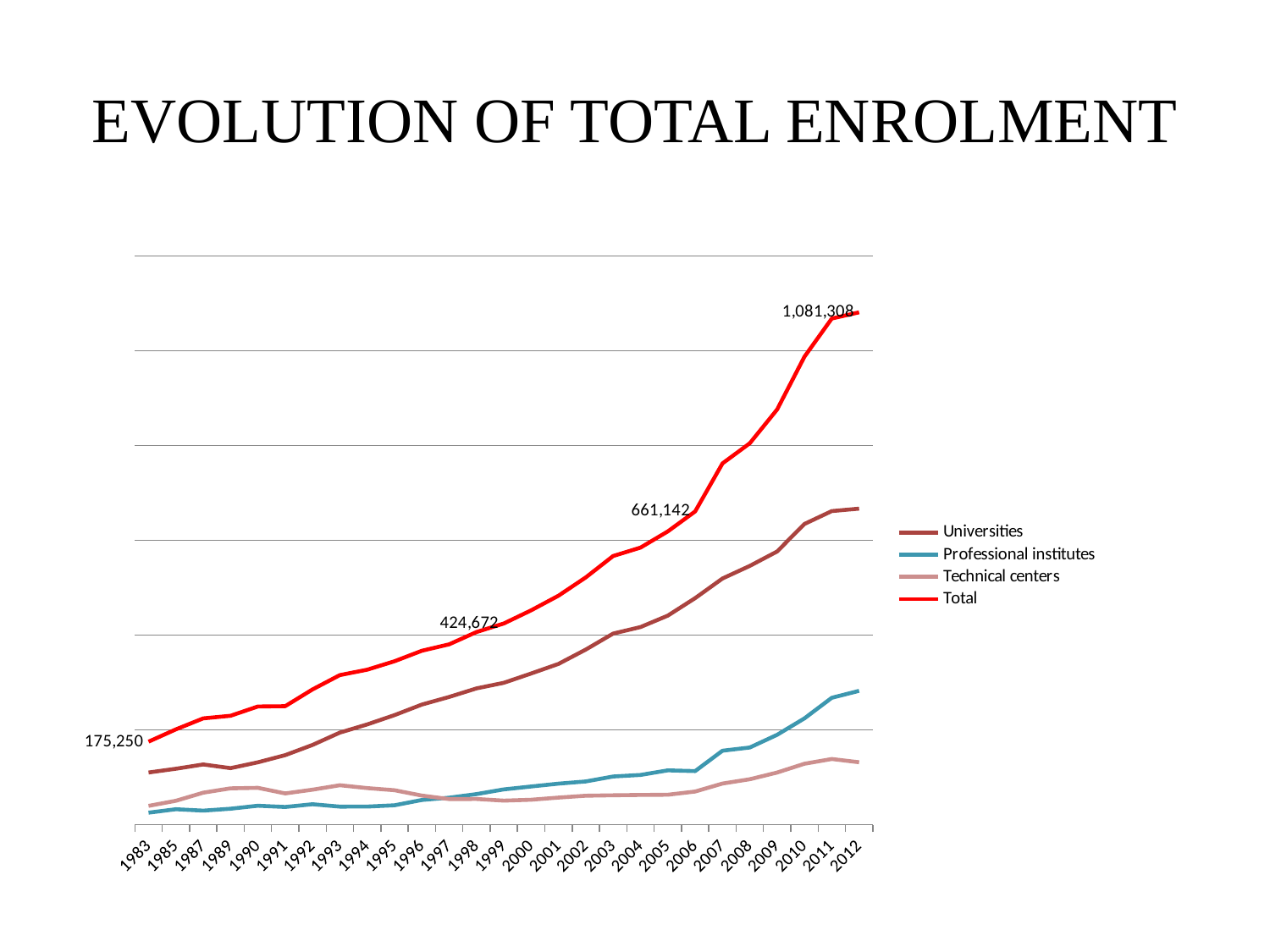
Which series has the lowest value in 2012? Technical centers In 2012, which is larger: Universities or Professional institutes? Universities Does the Total line rise or fall from 1983 to 2012? rises What is the title of the slide's chart? EVOLUTION OF TOTAL ENROLMENT What is the lowest value labelled on the Total line? 175,250 How many series does the legend list? 4 What is the difference between the labelled Total values 661,142 and 424,672? 236,470 What is the value of the Total line in 1983? 175,250 Which series has the highest value in 2012? Total What is the difference between the labelled Total values 1,081,308 and 175,250? 906,058 What is the highest value labelled on the Total line? 1,081,308 What kind of chart is shown on the slide? line chart